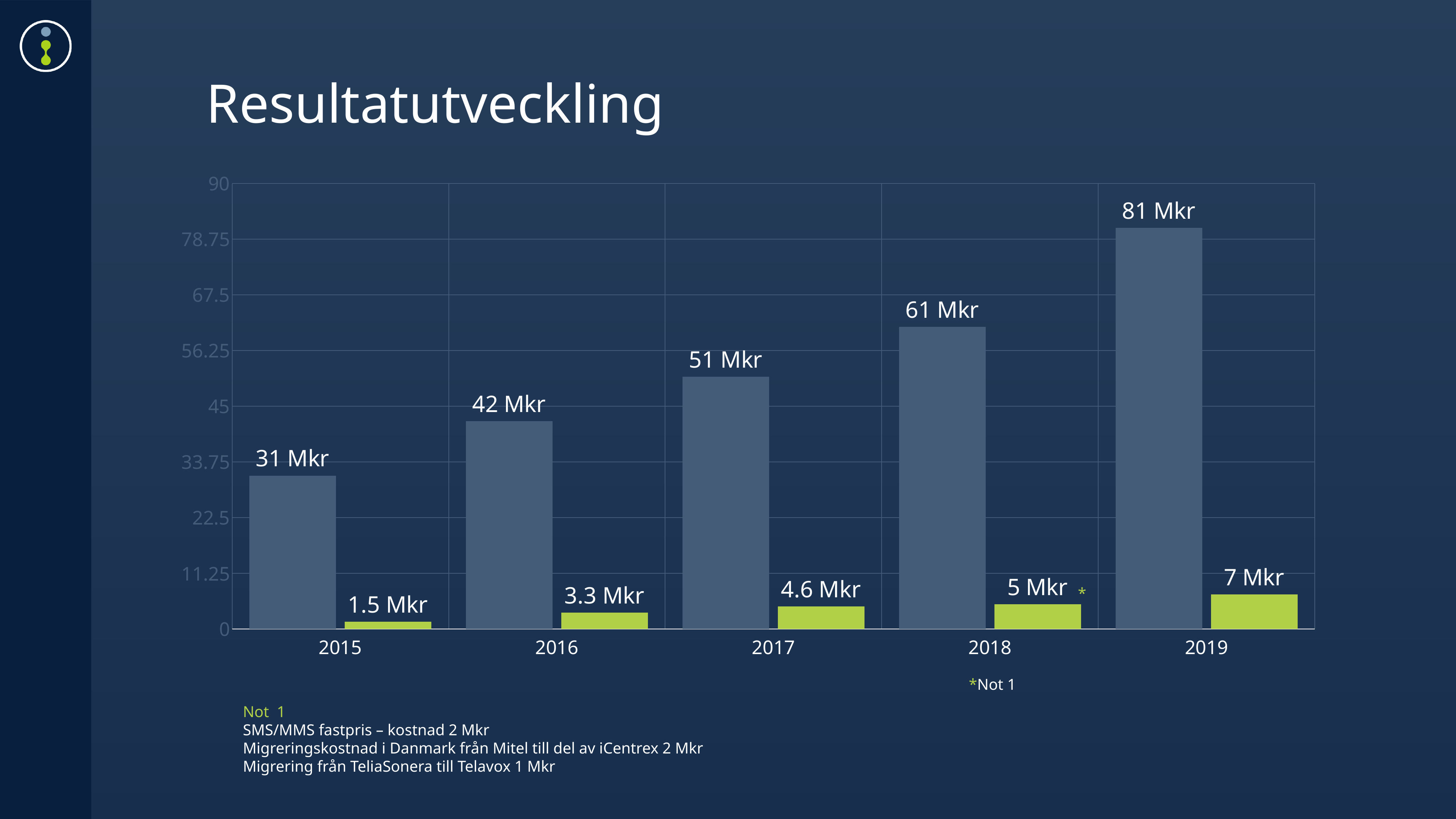
What is the value of the blue-grey bar for 2017? 51 Mkr What is the value of the green bar for 2018? 5 Mkr What is the value of the green bar for 2016? 3.3 Mkr What is the difference between the blue-grey bar values for 2019 and 2015? 50 Mkr How many years are shown on the x axis? 5 What kind of chart is shown on the slide? bar chart Which year has the highest blue-grey bar? 2019 Which year has the lowest green bar? 2015 Which is larger: the green bar for 2017 or the green bar for 2016? 2017 Do the blue-grey bar values rise or fall from 2015 to 2019? rise What is the value of the blue-grey bar for 2019? 81 Mkr What is the title of the slide containing the chart? Resultatutveckling